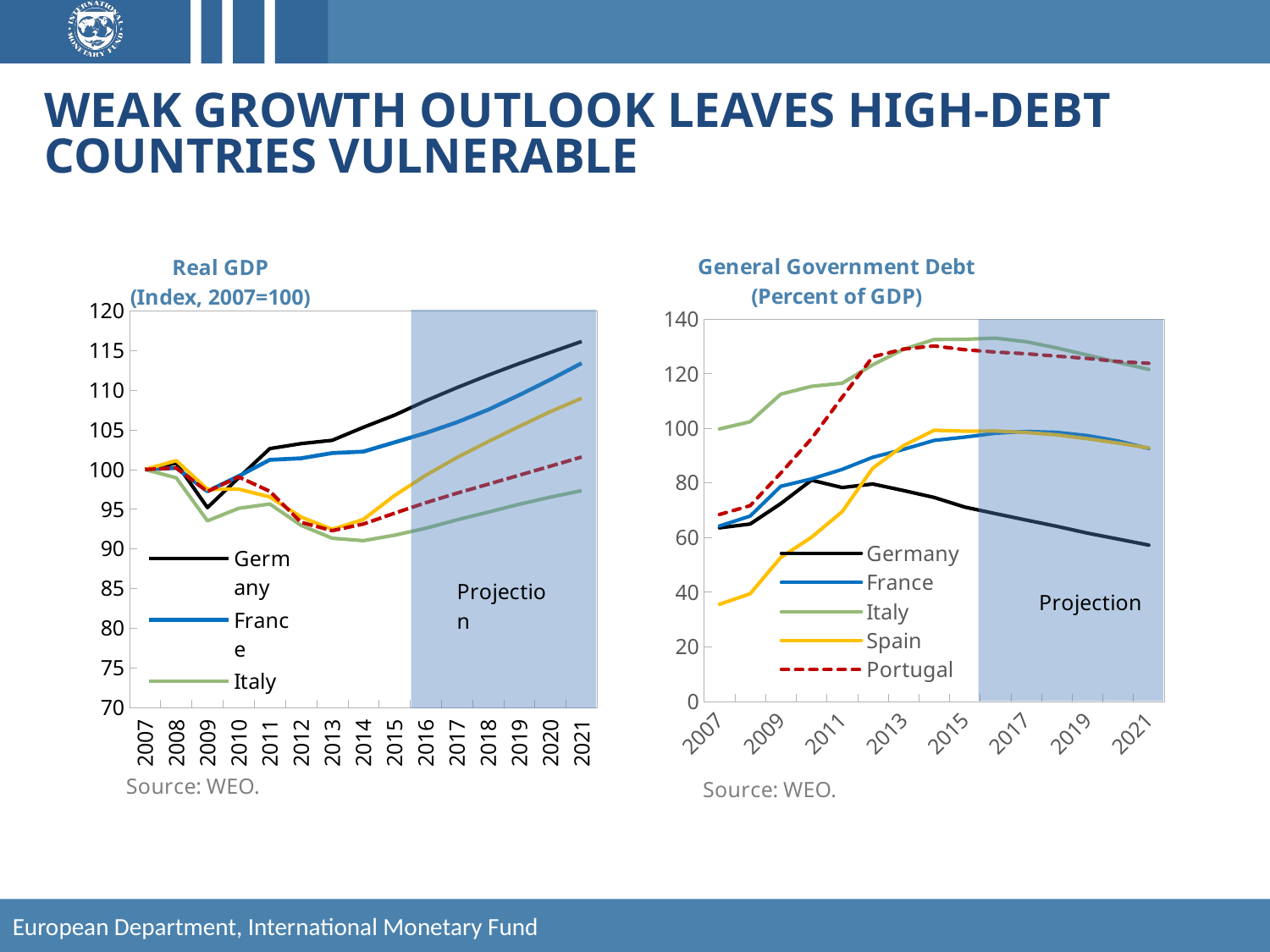
What label is shown in the shaded area on the right side of each chart? Projection In the General Government Debt chart, is the value for Spain in 2007 greater or less than 40? less In the Real GDP chart, is the value for Italy in 2021 greater or less than 100? less In the Real GDP chart, what is the index value for Germany in 2007? 100 How many series does the legend of the General Government Debt chart list? 5 How many series does the legend of the Real GDP chart list? 3 In the General Government Debt chart, is the value for Germany in 2021 greater or less than 60? less In the General Government Debt chart, which country has the lowest value in 2021? Germany What kind of chart is the Real GDP chart on the left? line chart In the General Government Debt chart, does Germany's debt rise or fall between 2015 and 2021? fall In the Real GDP chart, which country has the highest value in 2021? Germany